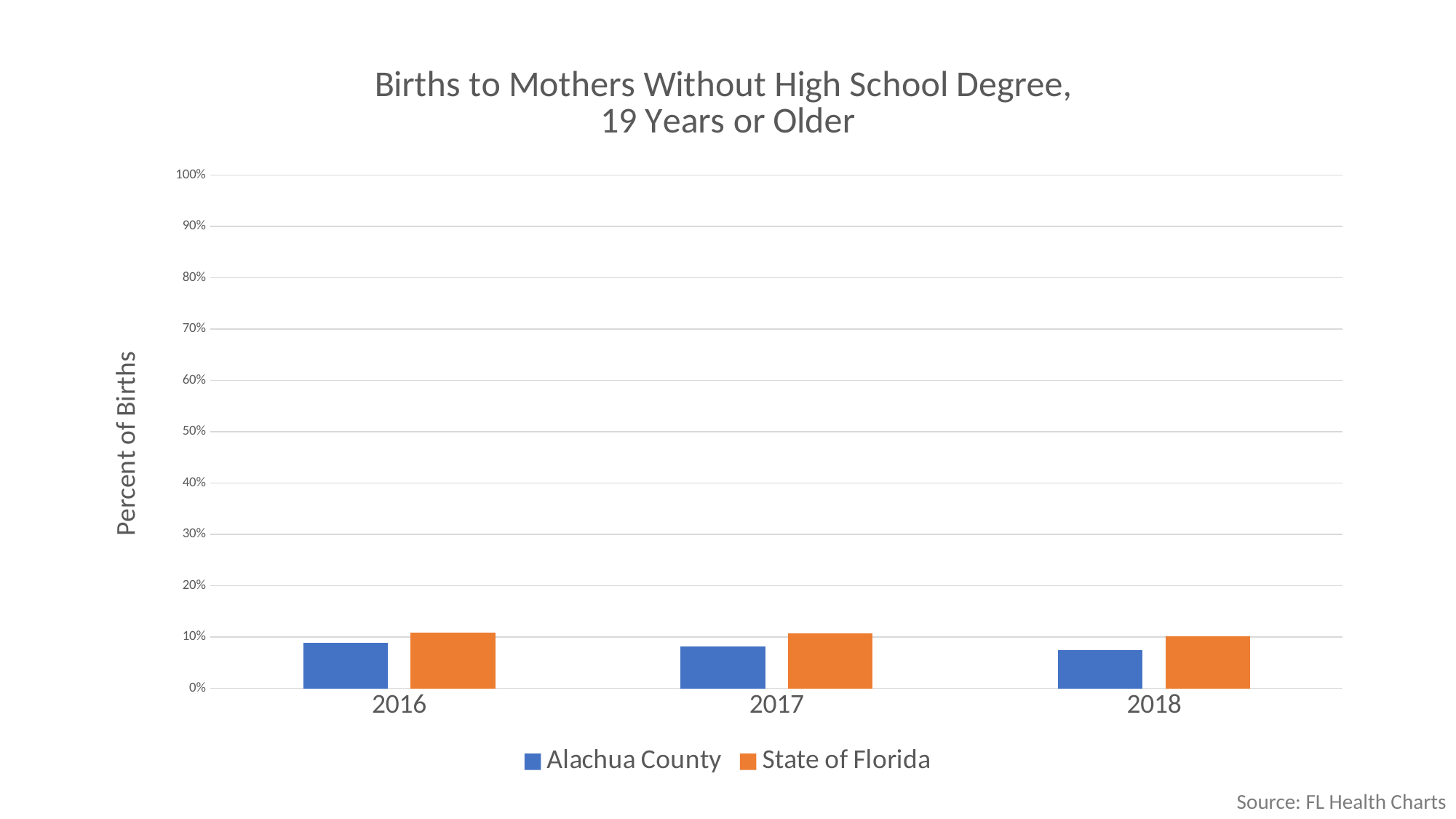
What kind of chart is shown on the slide? bar chart Is the value for Alachua County in 2018 greater or less than 10%? less In which year is the Alachua County value highest? 2016 What is the label on the y axis? Percent of Births How many series does the legend list? 2 How many years are shown on the x axis? 3 In 2017, which is larger: Alachua County or State of Florida? State of Florida Do the Alachua County values rise or fall from 2016 to 2018? fall In which year is the Alachua County value lowest? 2018 Is the value for Alachua County in 2016 greater or less than 10%? less